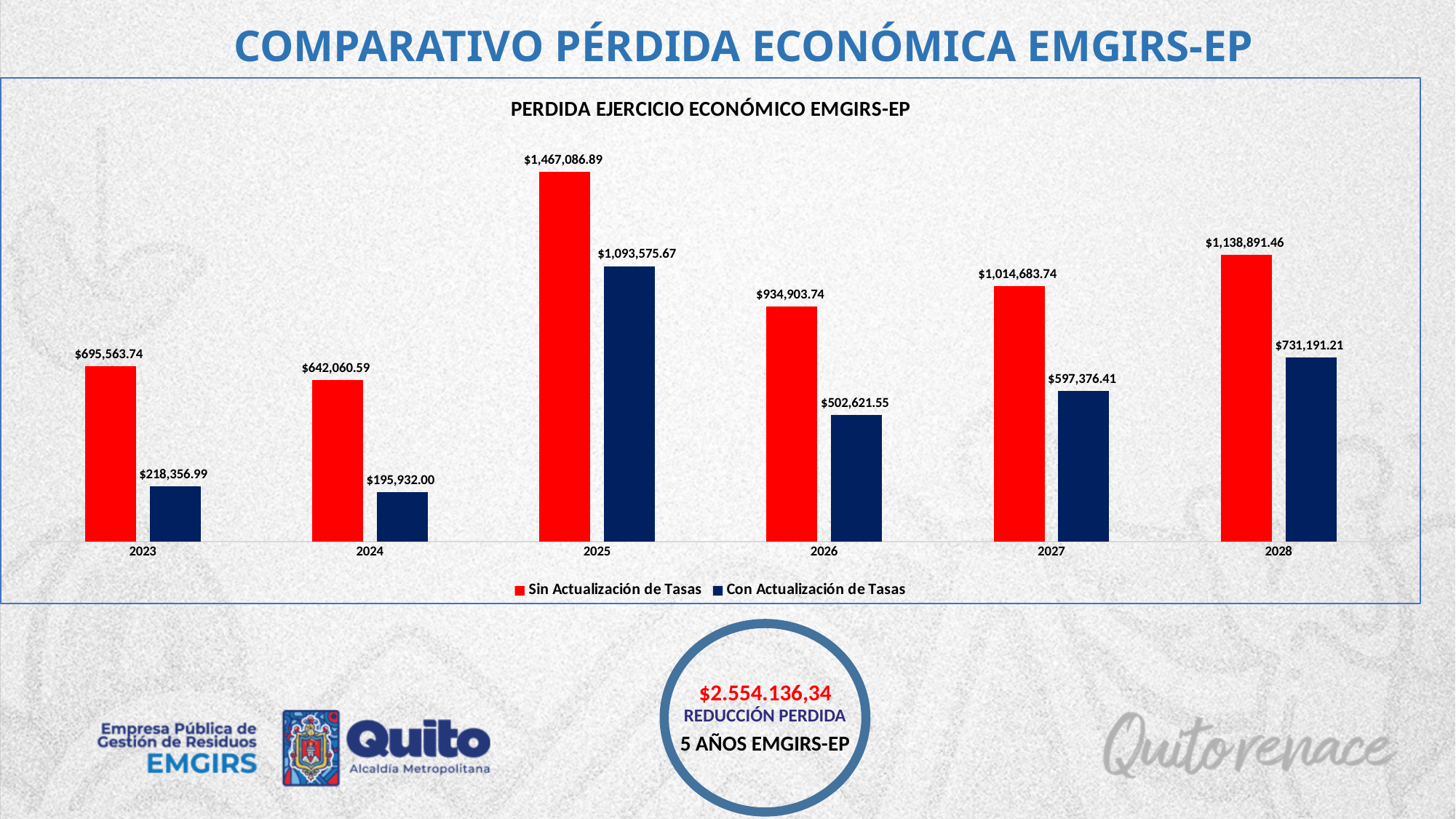
What is the difference between 'Sin Actualización de Tasas' and 'Con Actualización de Tasas' in 2025? $373,511.22 What is the difference between 'Sin Actualización de Tasas' and 'Con Actualización de Tasas' in 2023? $477,206.75 Which year has the highest value for 'Sin Actualización de Tasas'? 2025 What is the value for 'Con Actualización de Tasas' in 2028? $731,191.21 Which year has the lowest value for 'Con Actualización de Tasas'? 2024 What is the title of the chart? PERDIDA EJERCICIO ECONÓMICO EMGIRS-EP What is the value for 'Sin Actualización de Tasas' in 2025? $1,467,086.89 What is the value for 'Con Actualización de Tasas' in 2024? $195,932.00 Which is larger: 'Sin Actualización de Tasas' in 2026 or 'Sin Actualización de Tasas' in 2027? 2027 What type of chart is shown on the slide? Bar chart How many years are shown on the x axis of the chart? 6 How many series does the chart legend list? 2